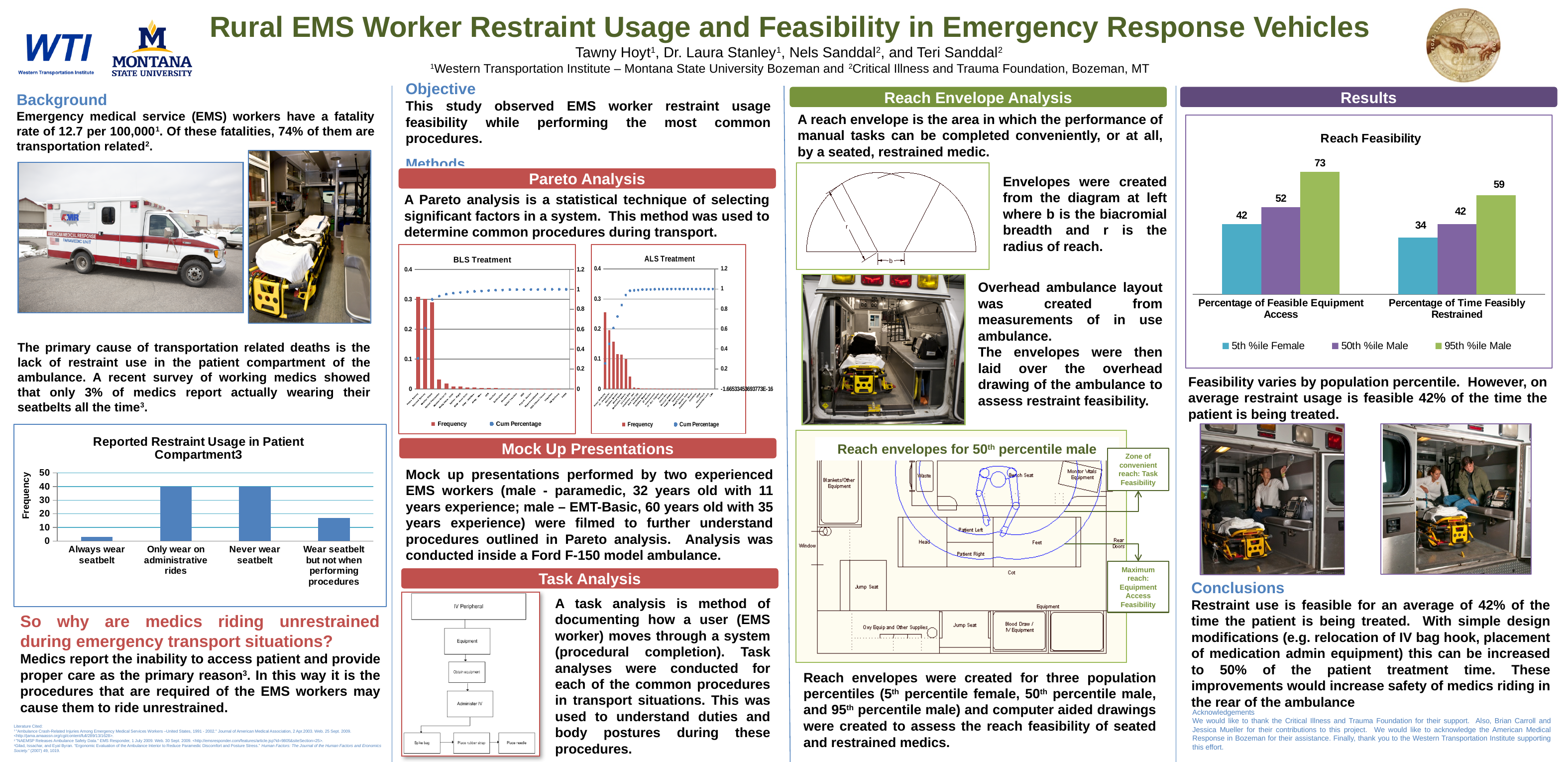
In the Reported Restraint Usage in Patient Compartment chart, is the value for Always wear seatbelt greater or less than 10? less In the Reach Feasibility chart, what is the value for 50th %ile Male under Percentage of Feasible Equipment Access? 52 How many series does the legend of the Reach Feasibility chart list? 3 In the Reach Feasibility chart, what is the value for 95th %ile Male under Percentage of Feasible Equipment Access? 73 In the Reach Feasibility chart, which series has the highest value for Percentage of Time Feasibly Restrained? 95th %ile Male What kind of chart is the Reach Feasibility chart? bar chart How many categories are shown on the x axis of the Reported Restraint Usage in Patient Compartment chart? 4 In the Reach Feasibility chart, what is the difference between the 95th %ile Male and 5th %ile Female values for Percentage of Feasible Equipment Access? 31 In the Reported Restraint Usage in Patient Compartment chart, is the value for Never wear seatbelt greater or less than 30? greater How many series does the legend of the BLS Treatment Pareto chart list? 2 In the Reach Feasibility chart, what is the value for 5th %ile Female under Percentage of Time Feasibly Restrained? 34 In the Reach Feasibility chart, which is larger: the 50th %ile Male value for Percentage of Feasible Equipment Access or for Percentage of Time Feasibly Restrained? Percentage of Feasible Equipment Access